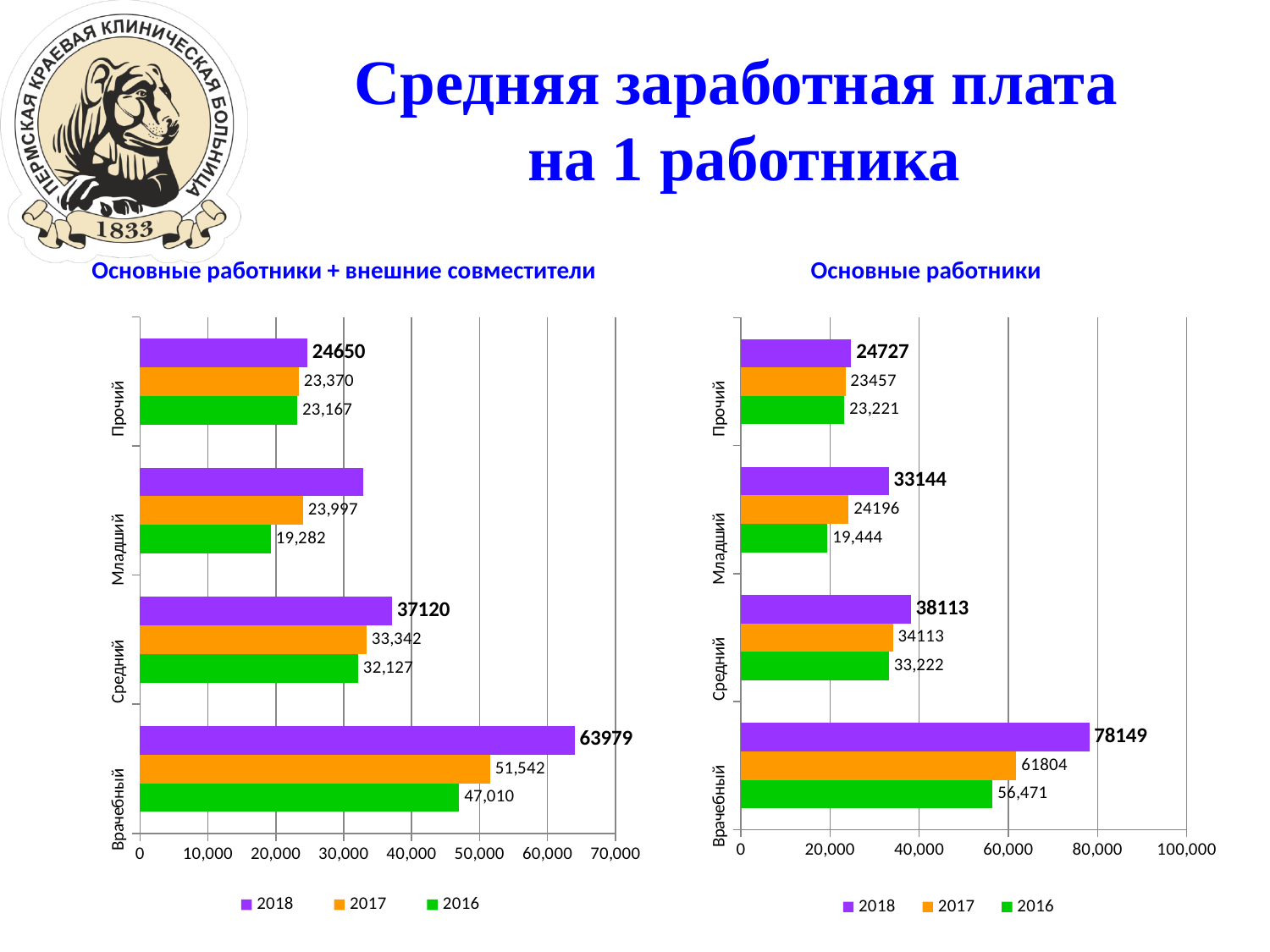
In the chart titled "Основные работники + внешние совместители", is the 2018 value for Младший greater or less than 30,000? greater In the chart titled "Основные работники", which category has the highest 2018 value? Врачебный In the chart titled "Основные работники + внешние совместители", which is larger for Средний: the 2017 value or the 2016 value? 2017 In the chart titled "Основные работники + внешние совместители", what is the 2016 value for Младший? 19,282 What type of chart is the chart titled "Основные работники"? bar chart In the chart titled "Основные работники", what is the 2016 value for Прочий? 23,221 How many categories are shown in the chart titled "Основные работники"? 4 In the chart titled "Основные работники + внешние совместители", what is the 2018 value for Врачебный? 63979 How many series does the legend list in the chart titled "Основные работники + внешние совместители"? 3 In the chart titled "Основные работники + внешние совместители", which category has the lowest 2016 value? Младший In the chart titled "Основные работники", what is the difference between the 2018 and 2017 values for Врачебный? 16345 In the chart titled "Основные работники", what is the 2017 value for Средний? 34113